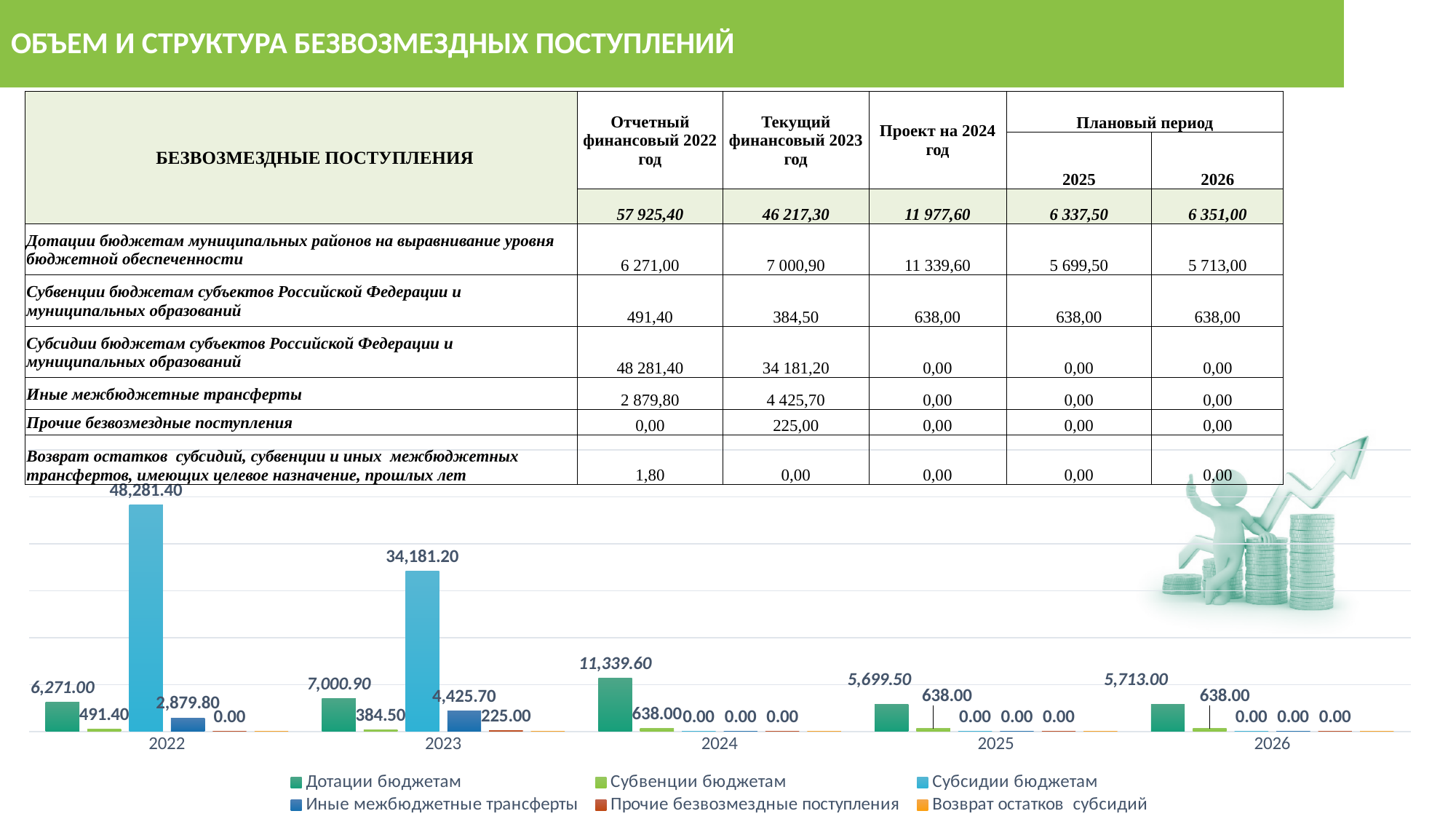
How many year categories are shown on the x axis of the bar chart? 5 What kind of chart is shown at the bottom of the slide? bar chart How many series does the legend of the bar chart list? 6 In the bar chart, does the value of Субсидии бюджетам rise or fall from 2022 to 2024? fall In the bar chart, which is larger: Дотации бюджетам in 2023 or Дотации бюджетам in 2022? Дотации бюджетам in 2023 In the bar chart, what is the value of Субсидии бюджетам for 2022? 48,281.40 In the bar chart, what is the value of Дотации бюджетам for 2024? 11,339.60 In the bar chart, which year has the highest value for Дотации бюджетам? 2024 In the bar chart, what is the value of Иные межбюджетные трансферты for 2023? 4,425.70 In the bar chart, which year has the lowest value for Дотации бюджетам? 2025 In the bar chart, what is the value of Субвенции бюджетам for 2025? 638.00 In the bar chart, what is the difference between Субсидии бюджетам in 2022 and in 2023? 14,100.20